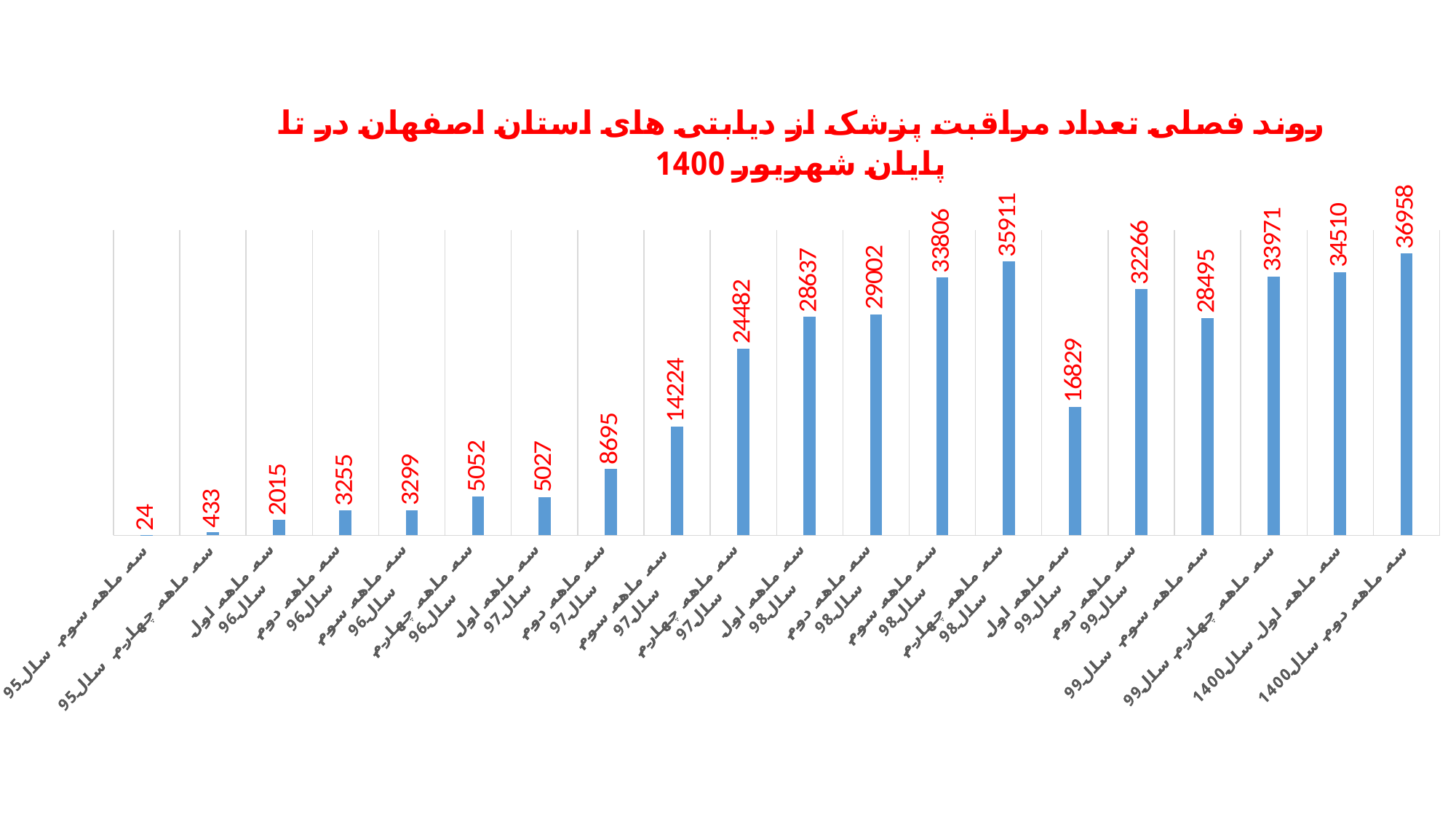
Which is larger: the value for سه ماهه چهارم سال96 or the value for سه ماهه اول سال97? سه ماهه چهارم سال96 What is the difference between the values for سه ماهه چهارم سال98 (35911) and سه ماهه اول سال99 (16829)? 19082 What is the value for سه ماهه اول سال99 (first quarter of 99)? 16829 What is the value for سه ماهه سوم سال97 (third quarter of 97)? 14224 Which quarter has the highest value in the chart? سه ماهه دوم سال1400 What is the value for سه ماهه دوم سال1400 (second quarter of 1400)? 36958 Do the values generally rise or fall from سه ماهه سوم سال95 to سه ماهه چهارم سال98? rise Which is larger: the value for سه ماهه دوم سال99 or the value for سه ماهه سوم سال99? سه ماهه دوم سال99 What colour are the bars in the chart? blue What type of chart is shown on the slide? bar chart How many bars (quarters) are plotted in the chart? 20 Which quarter has the lowest value in the chart? سه ماهه سوم سال95